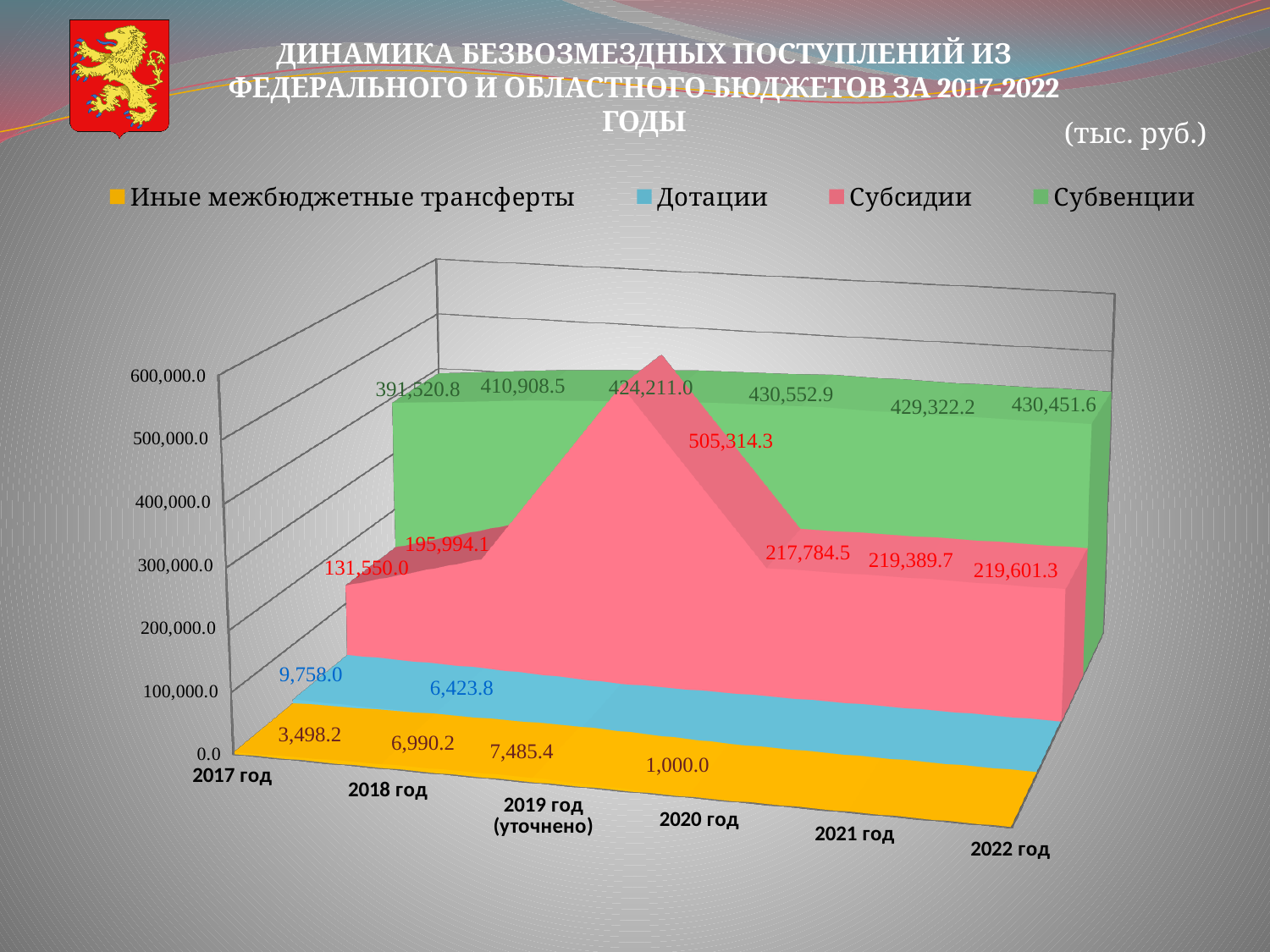
What kind of chart is shown on the slide? area chart What is the difference between the Субсидии values for 2022 год and 2021 год? 211.6 In which year is the value of Субвенции lowest? 2017 год In which year is the value of Субсидии highest? 2019 год (уточнено) What is the value of Субсидии for 2019 год (уточнено)? 505,314.3 How many series does the legend list? 4 What is the value of Дотации for 2017 год? 9,758.0 What is the difference between the Субвенции values for 2018 год and 2017 год? 19,387.7 What is the value of Субвенции for 2020 год? 430,552.9 What is the value of Иные межбюджетные трансферты for 2020 год? 1,000.0 Which is larger: Субсидии for 2018 год or Субсидии for 2020 год? 2020 год How many years are shown on the x axis? 6